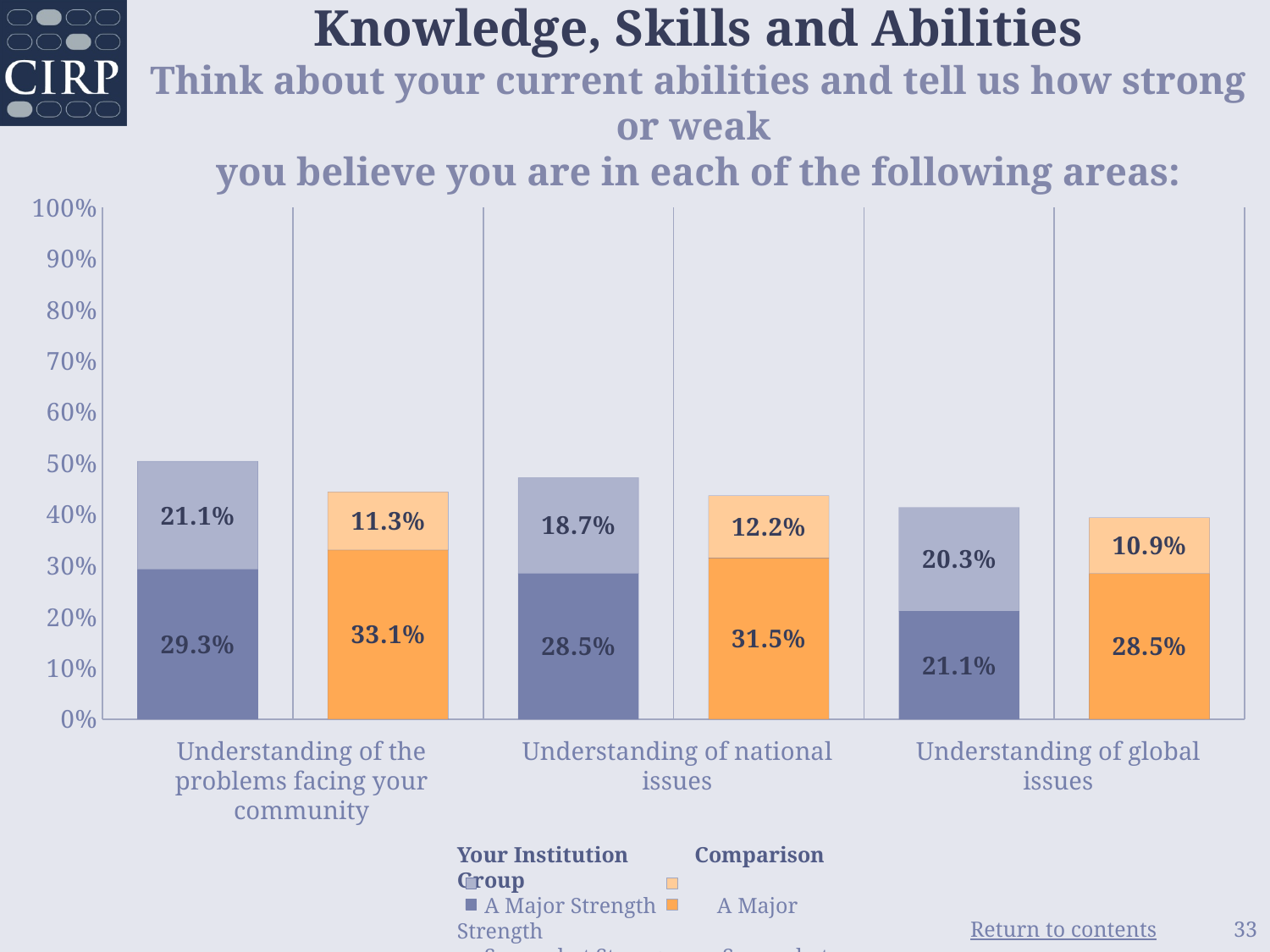
What value is printed on the upper, lighter segment of the Your Institution bar for 'Understanding of global issues'? 20.3% How many ability areas (categories) are shown on the x axis? 3 What type of chart is shown on the slide? Stacked bar chart What value is printed on the upper, lighter segment of the Comparison Group bar for 'Understanding of national issues'? 12.2% Among the three areas, for which does the Comparison Group have the lowest value in the upper, lighter segment? Understanding of global issues Among the three areas, for which does Your Institution have the highest 'A Major Strength' value? Understanding of the problems facing your community What is the total height of the Comparison Group stacked bar for 'Understanding of global issues'? 39.4% What is the total height of the Your Institution stacked bar for 'Understanding of the problems facing your community'? 50.4%